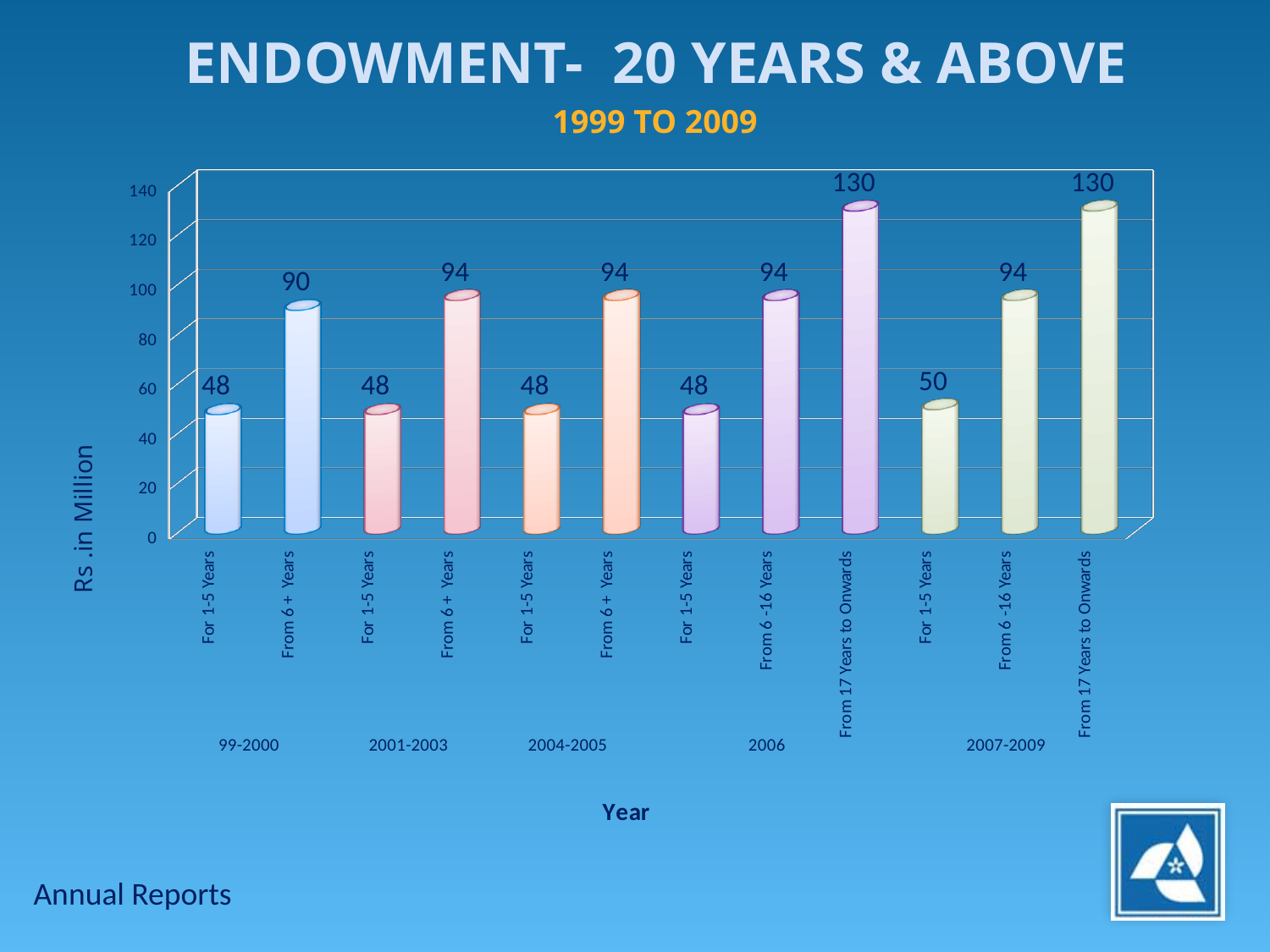
What is the label of the vertical axis? Rs .in Million What is the lowest value shown on the chart? 48 What is the difference between 'From 6 + Years' in 2001-2003 and 'From 6 + Years' in 99-2000? 4 Which is larger: 'For 1-5 Years' in 2007-2009 or 'For 1-5 Years' in 2006? For 1-5 Years in 2007-2009 What type of chart is shown on the slide? Bar chart What is the value for 'For 1-5 Years' in the 2007-2009 period? 50 What is the value for 'From 6 -16 Years' in the 2007-2009 period? 94 How many bars are plotted on the chart? 12 What is the value for 'From 17 Years to Onwards' in the 2006 period? 130 What is the highest value shown on the chart? 130 What is the value for 'From 6 + Years' in the 99-2000 period? 90 What is the difference between 'From 17 Years to Onwards' and 'For 1-5 Years' in the 2007-2009 period? 80